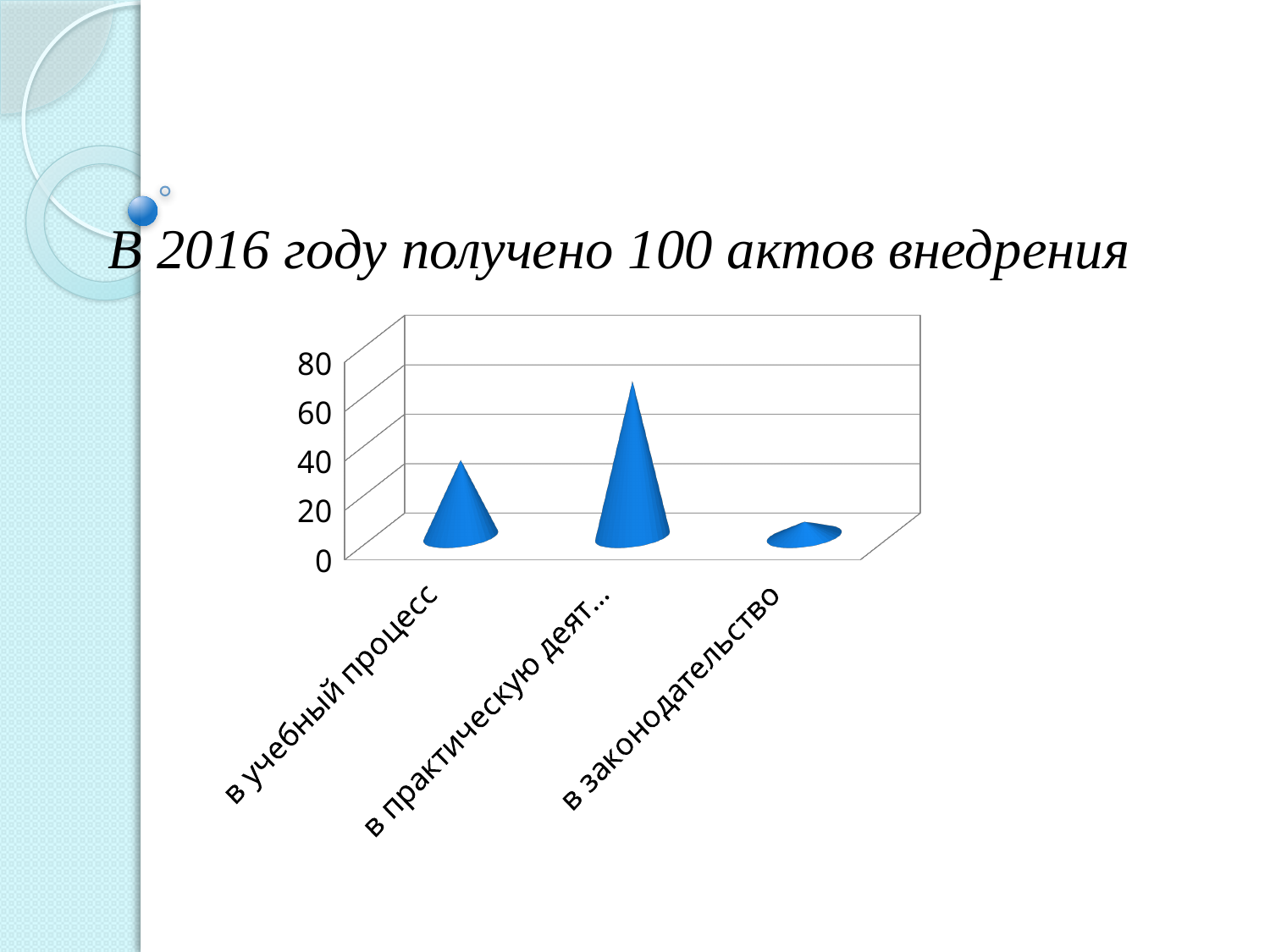
What is the highest value shown on the vertical axis? 80 Which category has the lowest value? в законодательство How many categories are plotted on the chart? 3 What kind of chart is shown on the slide? bar chart Is the value for the middle category ('в практическую деят...') greater or less than 60? greater Is the value for 'в учебный процесс' greater or less than 20? greater Which category has the highest value? в практическую деят... (the middle category) Is the value for the middle category ('в практическую деят...') greater or less than 80? less Which is larger: the value for 'в учебный процесс' or the value for 'в законодательство'? в учебный процесс What is the title shown above the chart? В 2016 году получено 100 актов внедрения